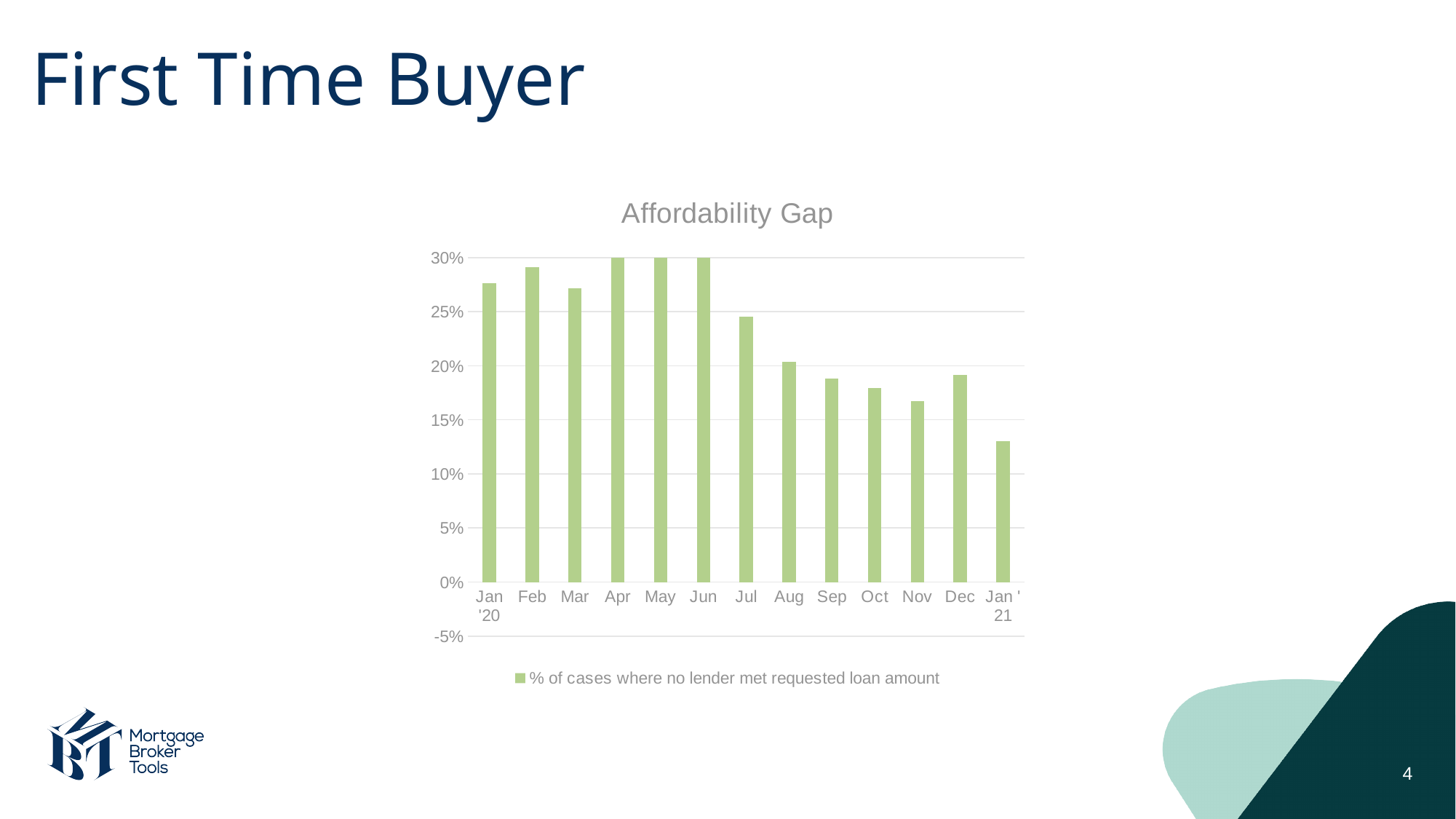
How many months are plotted on the x axis? 13 Is the value for Jan '21 greater or less than 15%? less Is the value for Nov greater or less than 20%? less How many series does the legend list? 1 What type of chart is shown on the slide? bar chart Which is larger, the value for Jan '20 or the value for Jan '21? Jan '20 Is the value for Feb greater or less than 25%? greater Which is larger, the value for Nov or the value for Dec? Dec What is the title of the chart? Affordability Gap Which month has the lowest value? Jan '21 Do the values generally rise or fall from Jan '20 to Jan '21? fall